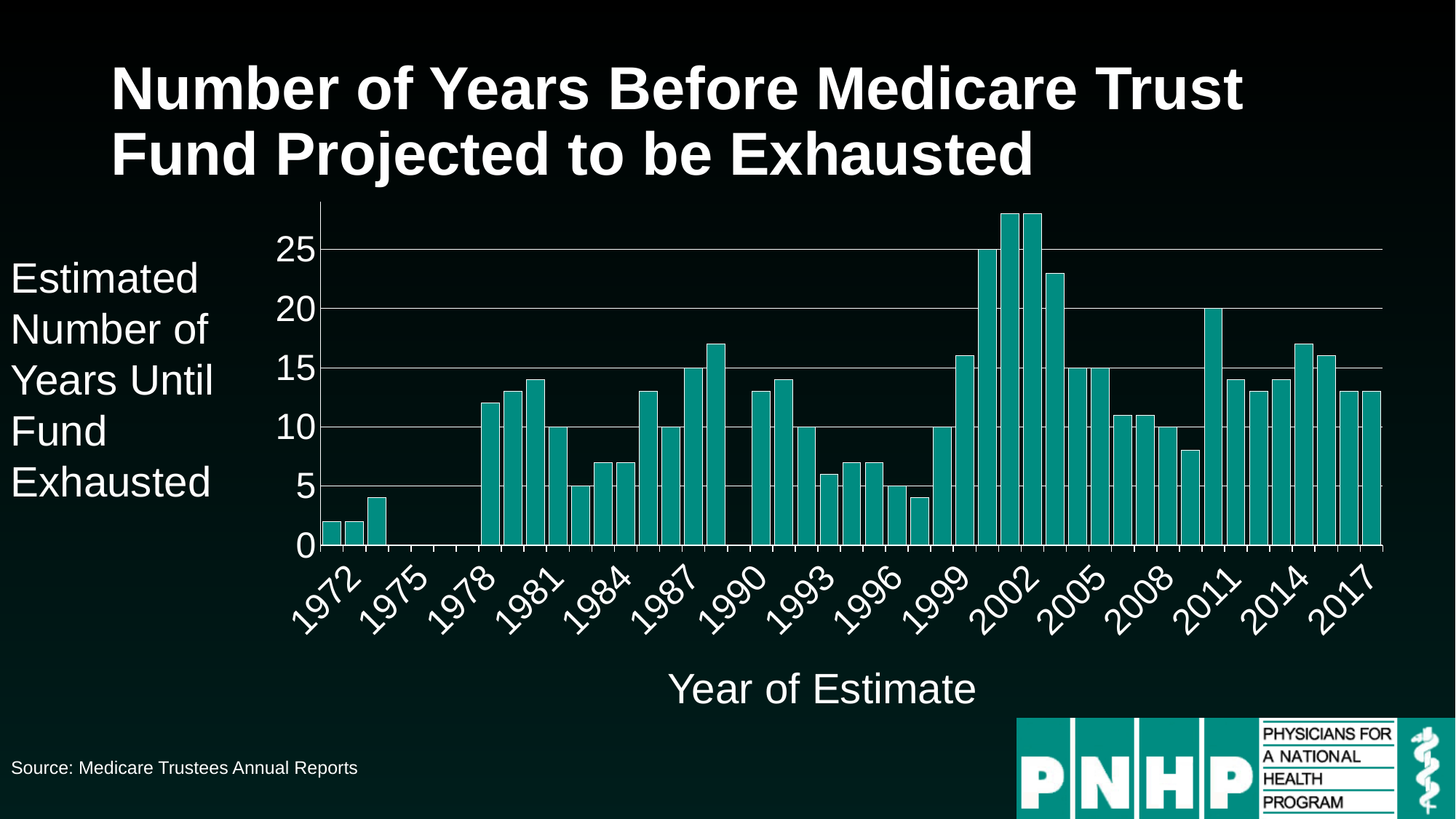
What is the estimated number of years until fund exhaustion for the 1987 estimate? 15 What is the estimated number of years until fund exhaustion for the 2005 estimate? 15 Is the value for the 2002 estimate greater or less than 25? greater How many year labels are shown on the x axis? 16 Among the years labeled on the x axis, which has the tallest bar? 2002 Is the value for the 1996 estimate greater or less than 10? less Which has the larger value, the 2002 estimate or the 1996 estimate? 2002 What type of chart is shown on the slide? bar chart What is the estimated number of years until fund exhaustion for the 2008 estimate? 10 What is the title of the x axis? Year of Estimate Is the value for the 2014 estimate greater or less than 15? greater